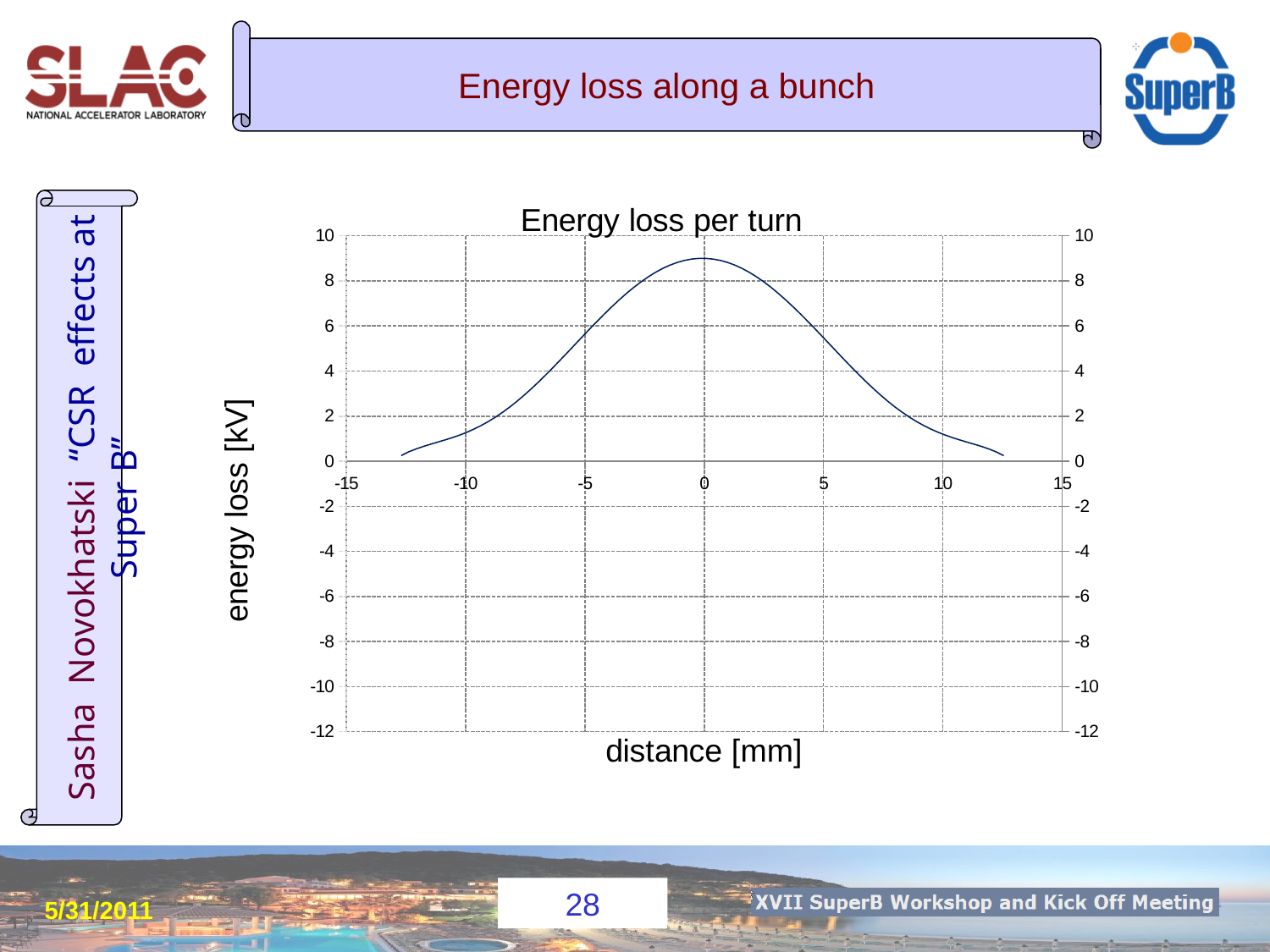
Is the energy loss at a distance of -10 mm greater or less than 2? less Is the energy loss at a distance of 10 mm greater or less than 2? less Does the energy loss rise or fall as the distance increases from 0 mm to 15 mm? fall Which is larger, the energy loss at a distance of 0 mm or at a distance of 10 mm? 0 mm Does the energy loss rise or fall as the distance increases from -15 mm to 0 mm? rise Is the energy loss at a distance of 0 mm greater or less than 10? less What is the label of the x axis of the chart? distance [mm] What is the title of the chart? Energy loss per turn What kind of chart is shown on the slide? line chart At which distance does the energy loss curve reach its highest value? 0